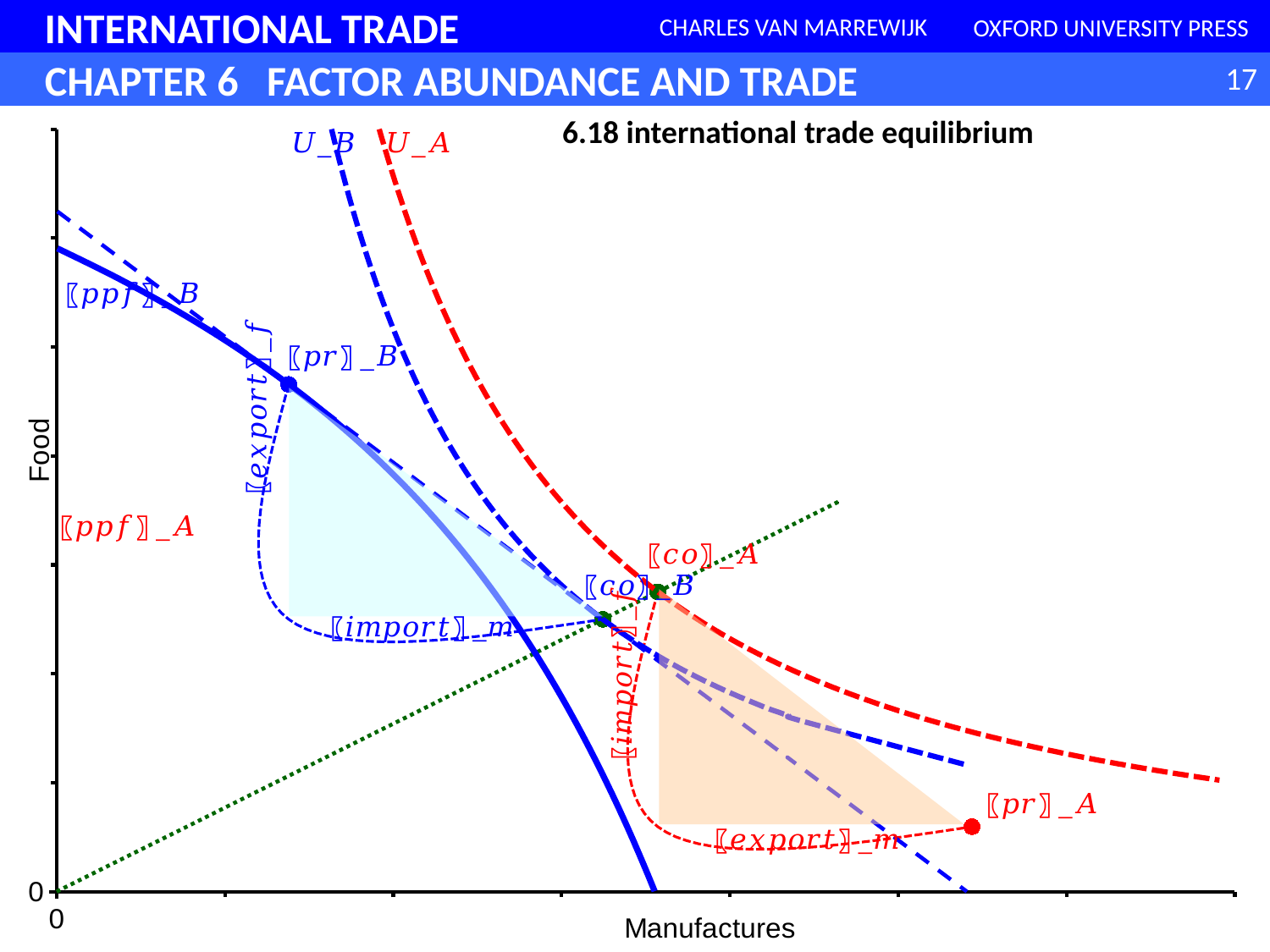
Which of the two production points, pr_A or pr_B, is lowest on the Food axis? pr_A What is the label of the horizontal axis of the chart? Manufactures What is the title of the chart on the slide? 6.18 international trade equilibrium What kind of chart is shown on the slide? line chart Which point has the higher Food value, pr_B or pr_A? pr_B Which point has the lower Food value, co_B or pr_B? co_B Which point lies further to the right along the Manufactures axis, co_A or pr_B? co_A